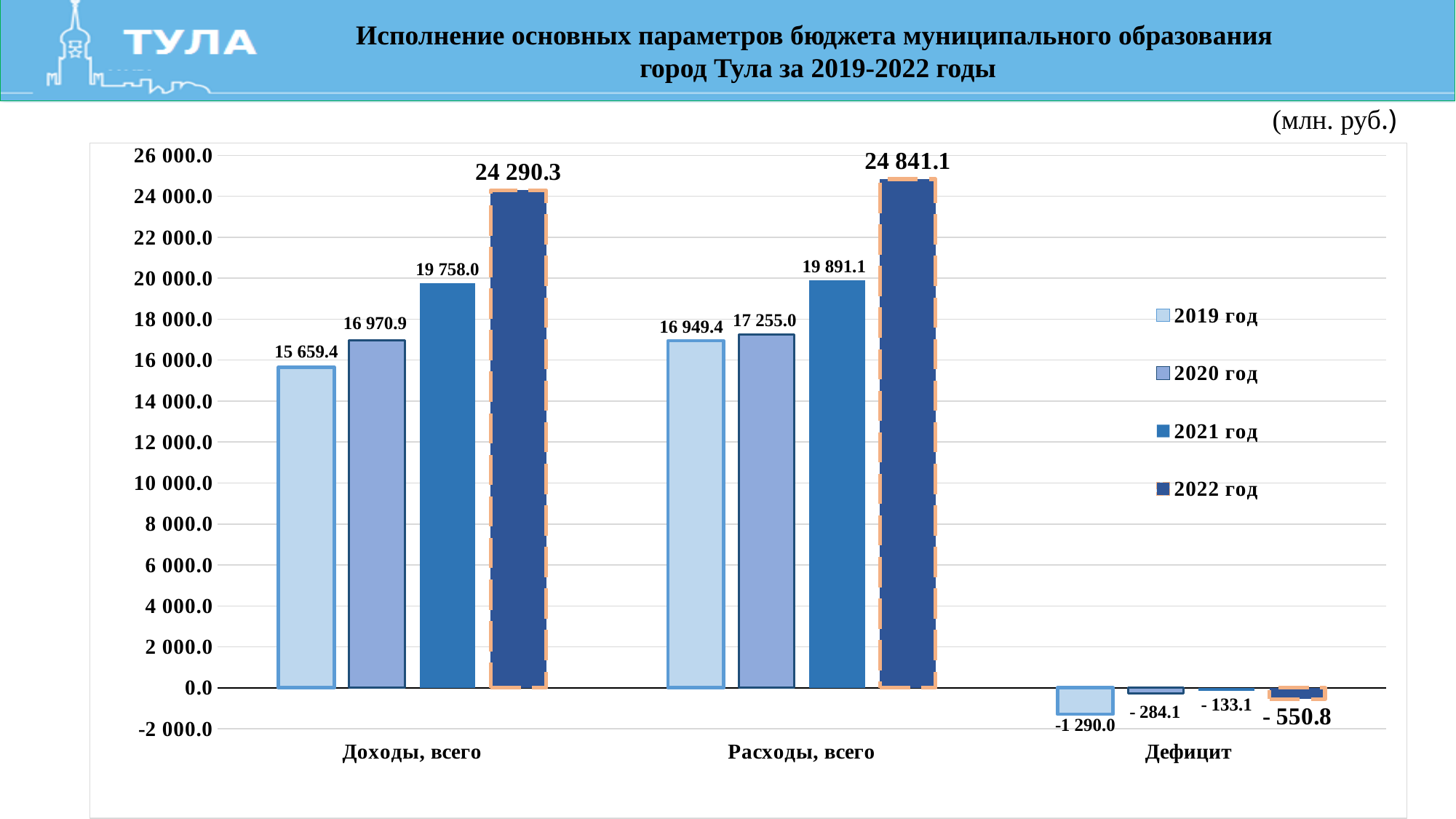
Is the value for Доходы, всего in 2021 год greater or less than 18 000.0? greater Which is larger in 2019 год: Доходы, всего or Расходы, всего? Расходы, всего How many series does the legend list? 4 Which year has the highest value for Расходы, всего? 2022 год What is the value for Доходы, всего in 2022 год? 24 290.3 Do the values for Доходы, всего rise or fall from 2019 год to 2022 год? rise What is the value for Дефицит in 2019 год? -1 290.0 What is the value for Расходы, всего in 2021 год? 19 891.1 How many categories are shown on the x axis? 3 What is the difference between Расходы, всего and Доходы, всего in 2022 год? 550.8 Which year has the lowest value for Доходы, всего? 2019 год What is the value for Доходы, всего in 2020 год? 16 970.9